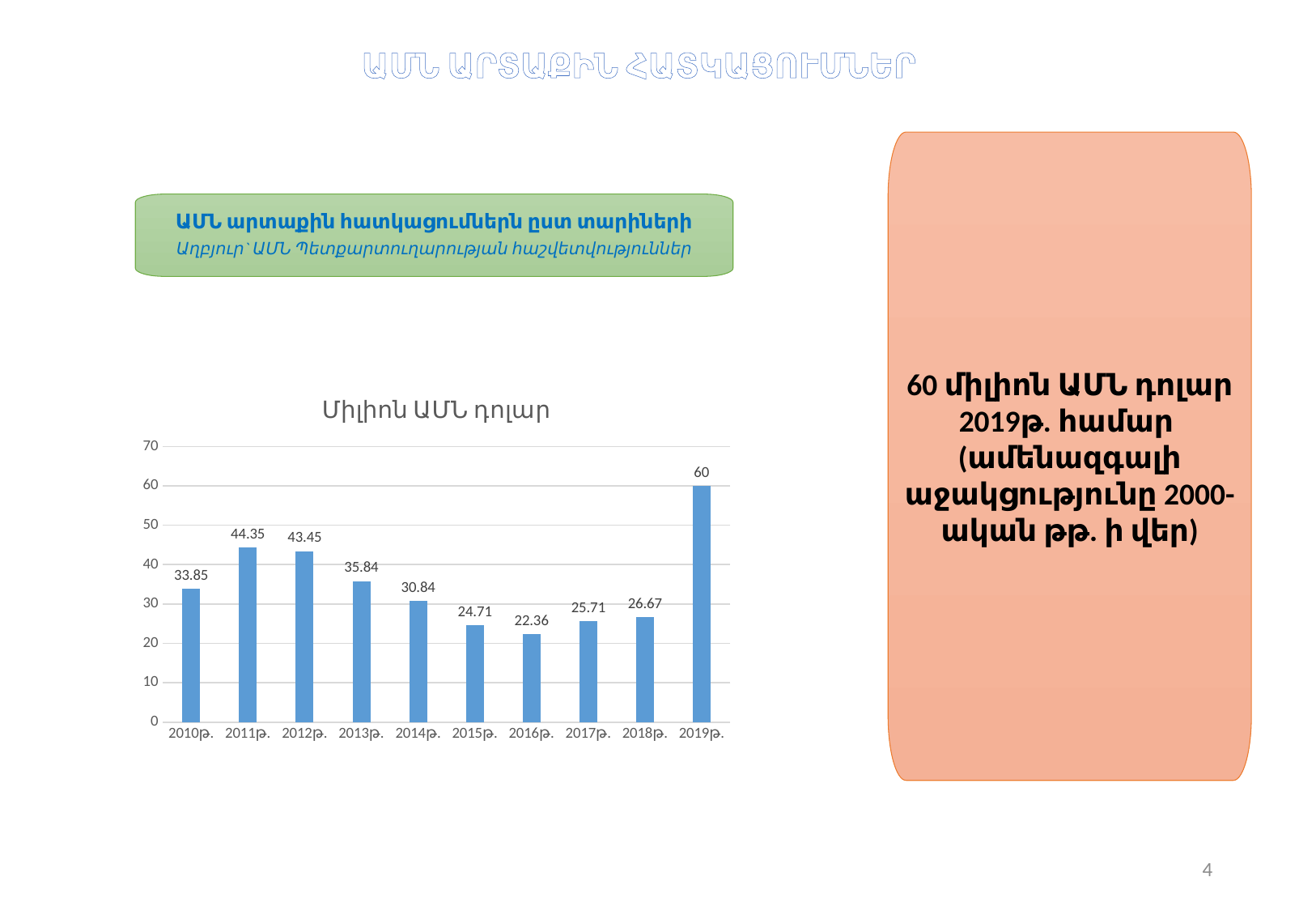
Which year has the highest value in the chart? 2019թ. What is the value for 2013թ. in the chart? 35.84 Is the value for 2015թ. greater or less than 30? less How many years are shown on the x axis of the chart? 10 Which year has the lowest value in the chart? 2016թ. What kind of chart is shown on the slide? bar chart What is the value for 2016թ. in the chart? 22.36 What is the difference between the values for 2011թ. and 2010թ.? 10.5 What is the difference between the values for 2019թ. and 2018թ.? 33.33 What is the value for 2019թ. in the chart? 60 What is the title of the chart? Միլիոն ԱՄՆ դոլար Which is larger, the value for 2012թ. or the value for 2014թ.? 2012թ.